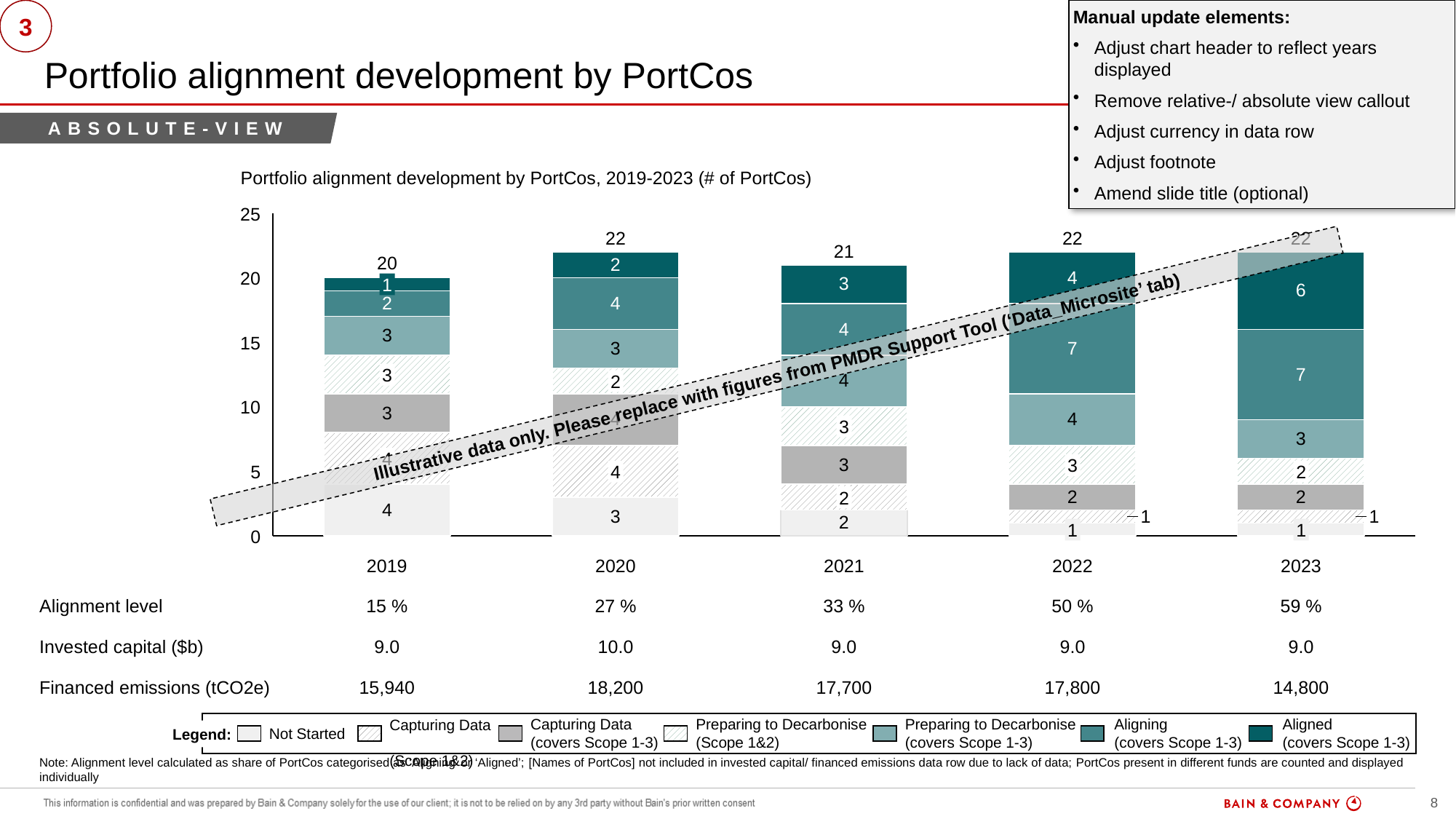
What is the difference between the 'Aligned (covers Scope 1-3)' values for 2023 and 2019? 5 What kind of chart is shown on the slide? Stacked bar chart Which year has the larger 'Aligning (covers Scope 1-3)' segment, 2021 or 2022? 2022 How many categories does the legend list? 7 How many PortCos are in the 'Aligned (covers Scope 1-3)' segment in 2023? 6 What is the title of the chart? Portfolio alignment development by PortCos, 2019-2023 (# of PortCos) How many PortCos are in the 'Aligning (covers Scope 1-3)' segment in 2022? 7 What is the total number of PortCos shown for 2019? 20 How many years are shown on the x axis of the chart? 5 Does the 'Aligned (covers Scope 1-3)' segment rise or fall from 2019 to 2023? Rise Which year has the lowest total number of PortCos? 2019 How many PortCos are in the 'Not Started' segment in 2019? 4